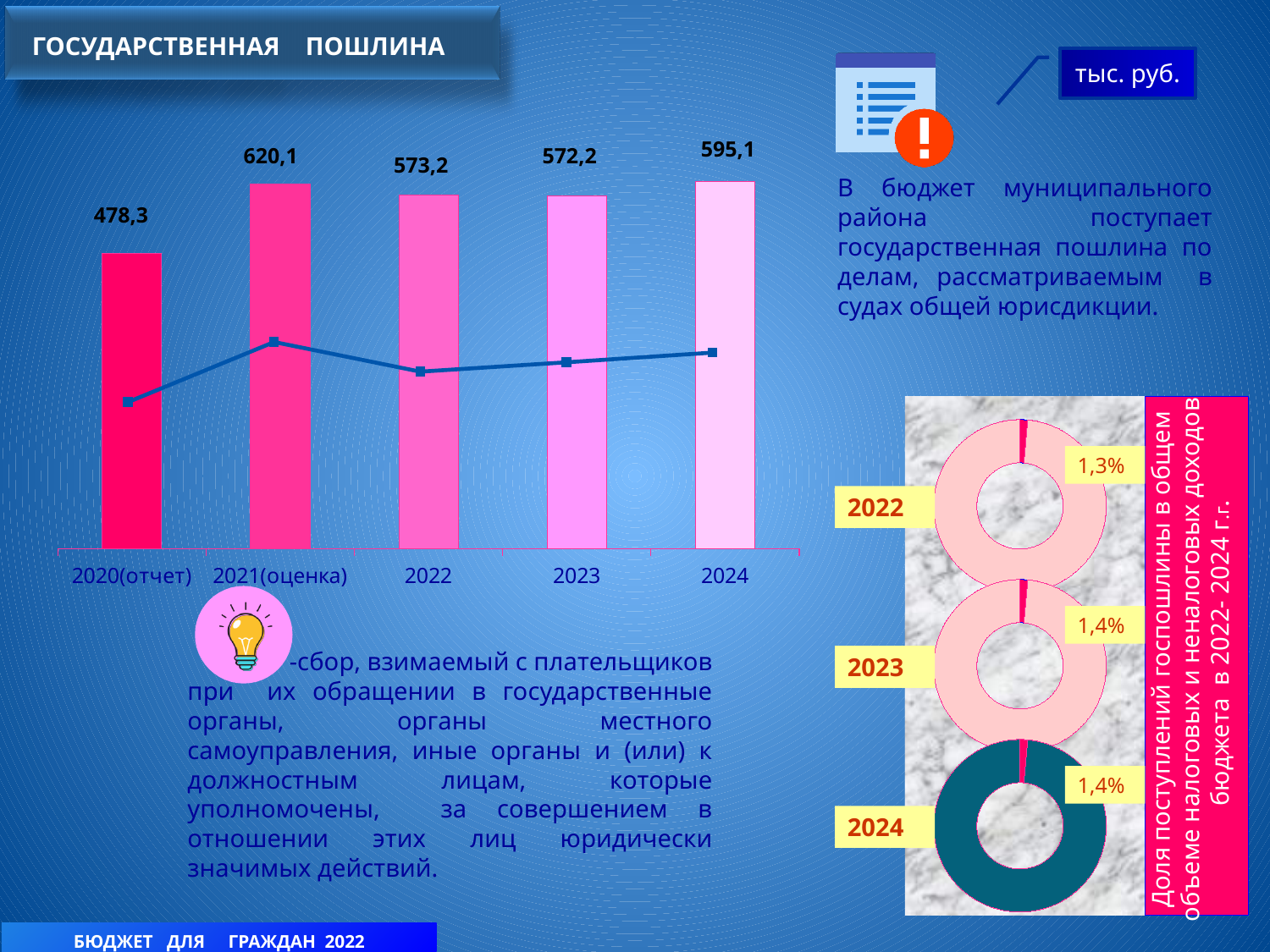
In the bar chart on the left, does the value rise or fall from 2020(отчет) to 2021(оценка)? rise In the bar chart on the left, what is the value for 2021(оценка)? 620,1 In the doughnut charts on the right, what share is shown for 2024? 1,4% In the bar chart on the left, which category has the highest value? 2021(оценка) How many categories are shown in the bar chart on the left? 5 In the bar chart on the left, which category has the lowest value? 2020(отчет) In the bar chart on the left, what is the difference between the values for 2021(оценка) and 2020(отчет)? 141,8 In the bar chart on the left, which is larger, the value for 2022 or the value for 2023? 2022 In the bar chart on the left, what is the value for 2024? 595,1 In the bar chart on the left, what is the value for 2020(отчет)? 478,3 In the bar chart on the left, what is the difference between the values for 2024 and 2023? 22,9 In the doughnut charts on the right, what share is shown for 2022? 1,3%